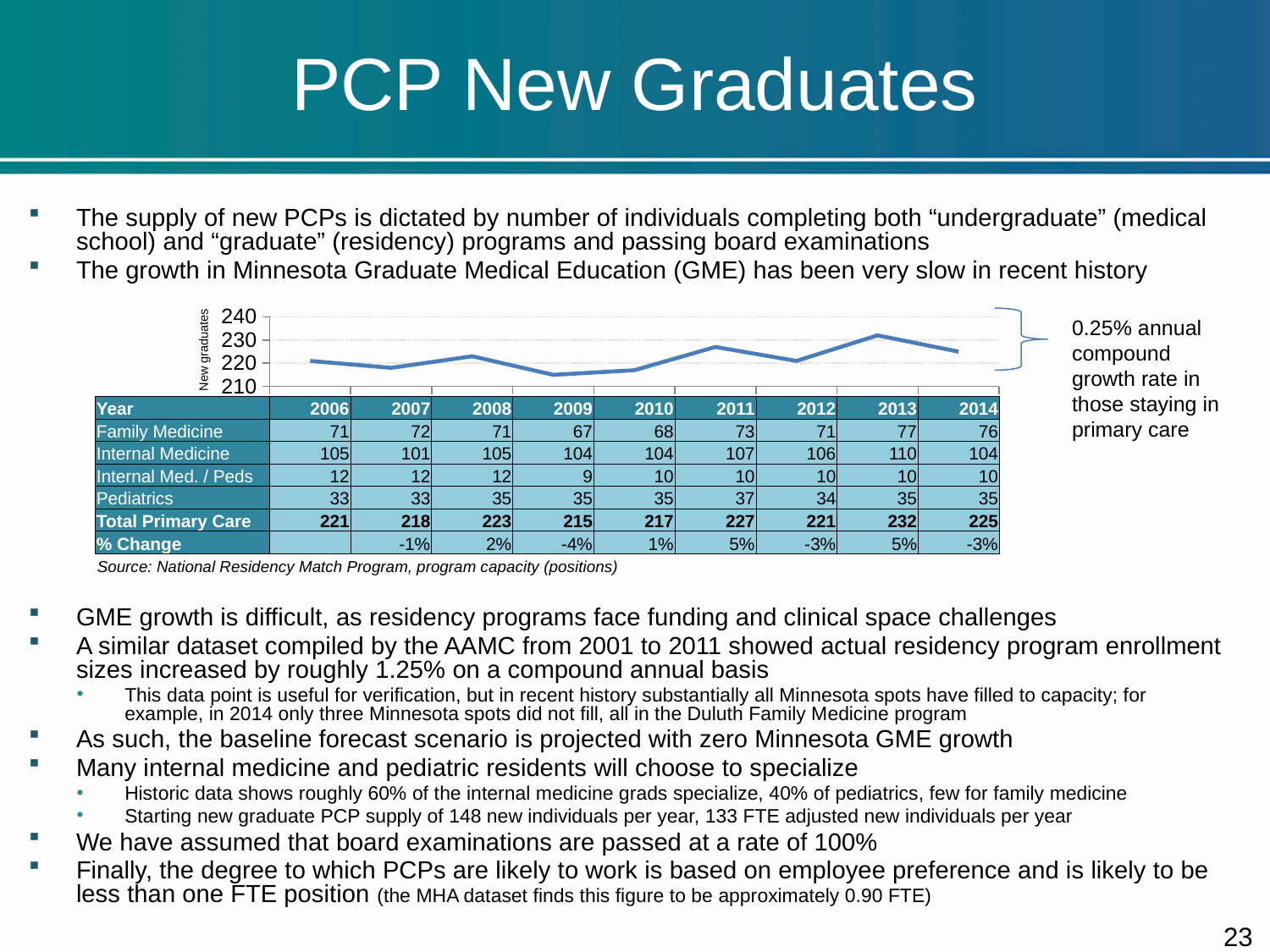
What is the % Change shown in the data table for 2011? 5% What is the label on the vertical axis of the chart? New graduates Which year has the highest Total Primary Care value? 2013 What is the Total Primary Care value plotted for 2009? 215 What is the Total Primary Care value plotted for 2013? 232 Which year has the lowest Total Primary Care value? 2009 What is the Family Medicine value shown in the data table for 2013? 77 How many years are plotted on the x axis of the chart? 9 Which year has a larger Total Primary Care value, 2011 or 2012? 2011 What type of chart is shown on the slide? line chart Is the plotted value for 2013 greater or less than 230? greater What is the difference between the Total Primary Care values for 2013 and 2009? 17